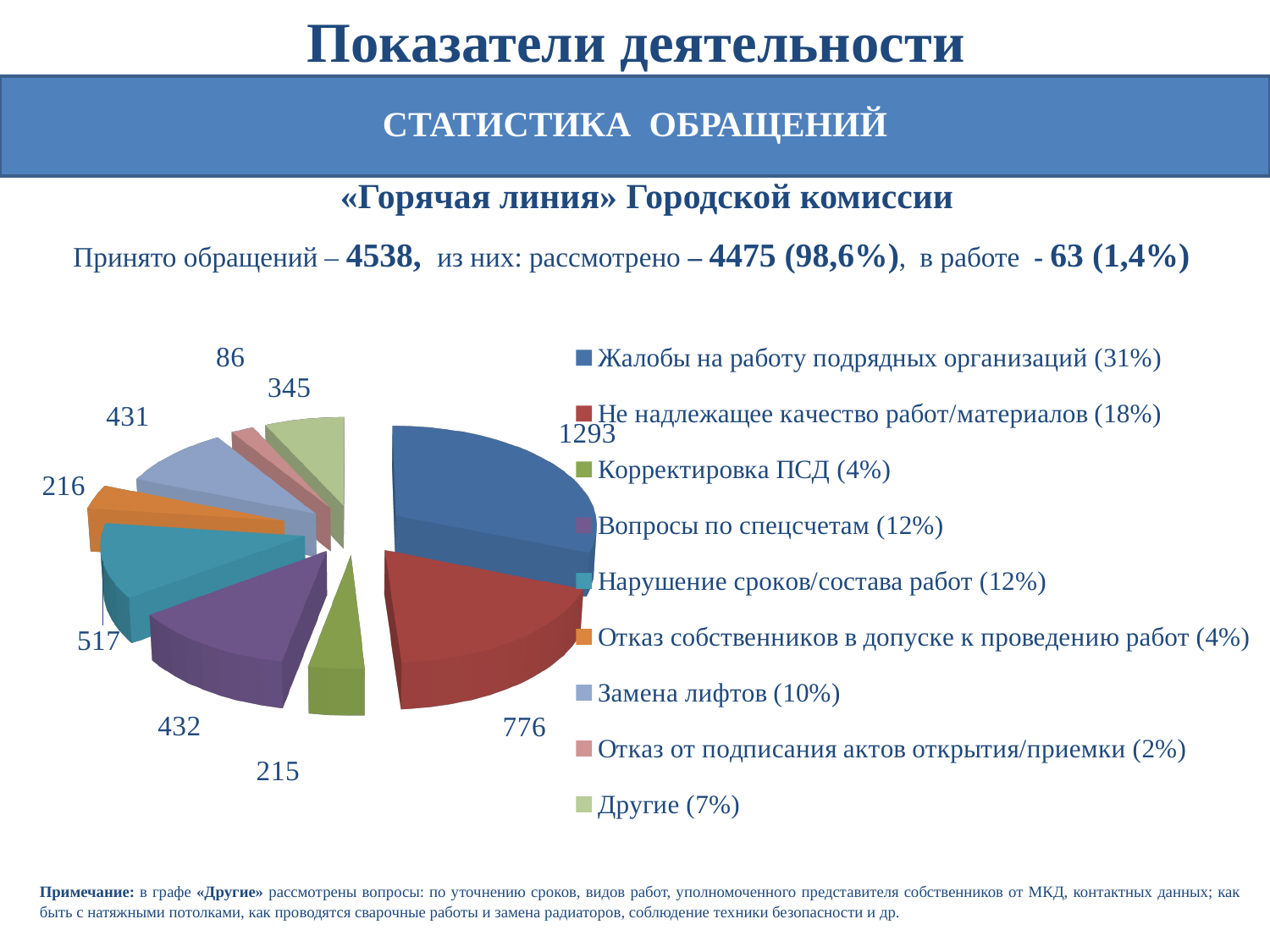
How many slices does the pie chart have? 9 Which category has the smallest slice in the pie chart? Отказ от подписания актов открытия/приемки What share of the pie does Вопросы по спецсчетам represent? 12% What is the value shown for Корректировка ПСД? 215 What share of the pie does Другие represent? 7% What is the difference between the values for Жалобы на работу подрядных организаций and Не надлежащее качество работ/материалов? 517 What kind of chart is shown on the slide? pie chart What is the value shown for Другие? 345 Which is larger: the value for Нарушение сроков/состава работ or the value for Вопросы по спецсчетам? Нарушение сроков/состава работ What is the value shown for Замена лифтов? 431 Which category has the largest slice in the pie chart? Жалобы на работу подрядных организаций What is the value shown for Жалобы на работу подрядных организаций? 1293